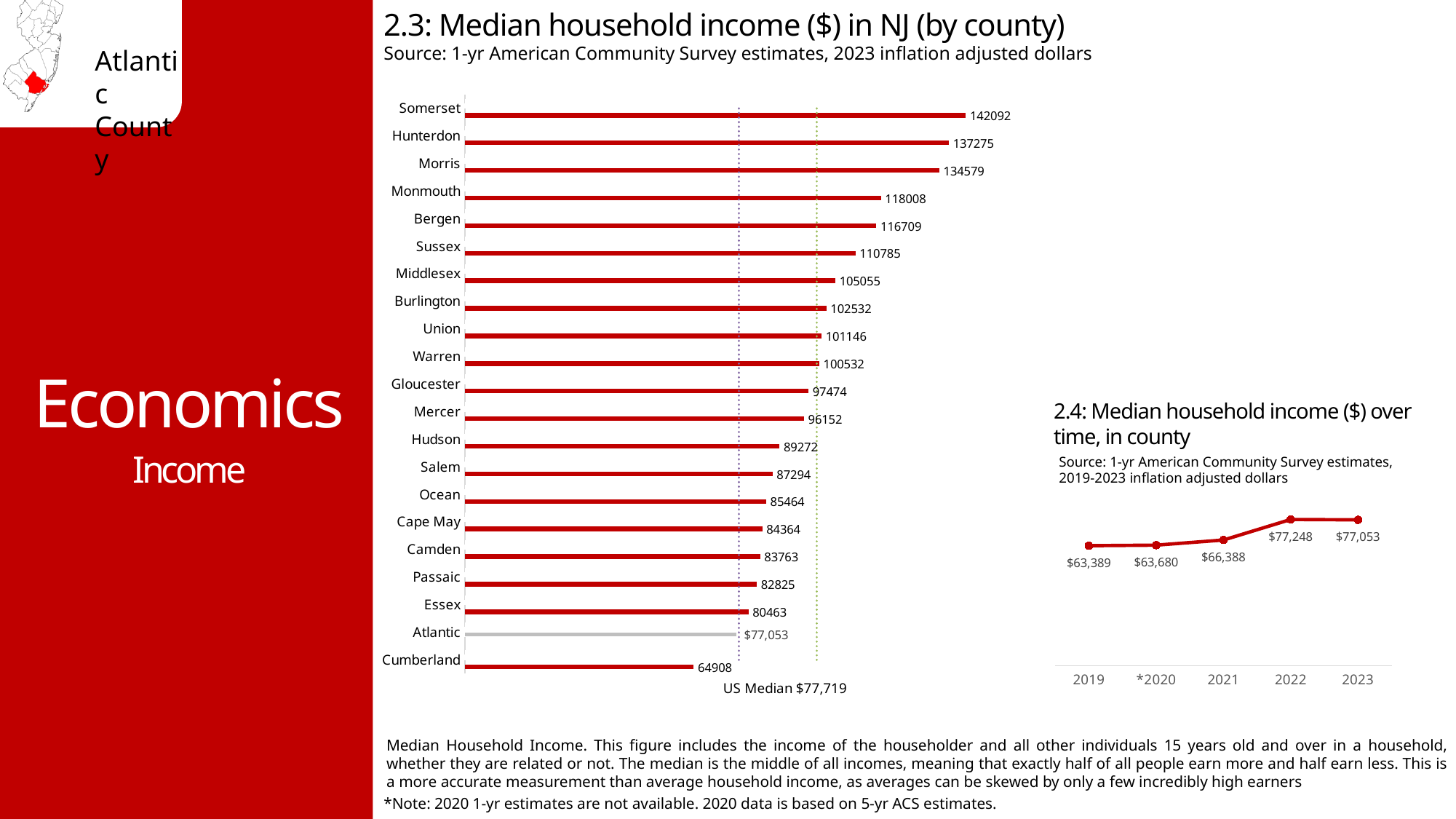
In chart 2.3 (Median household income in NJ by county), which county has the lowest median household income? Cumberland In chart 2.3 (Median household income in NJ by county), what is the median household income for Somerset? 142092 In chart 2.3 (Median household income in NJ by county), how many counties are plotted? 21 In chart 2.3 (Median household income in NJ by county), which county has the highest median household income? Somerset In chart 2.4 (Median household income over time, in county), which year has the highest median household income? 2022 What kind of chart is chart 2.3 (Median household income in NJ by county)? Bar chart In chart 2.4 (Median household income over time, in county), how many years are plotted? 5 In chart 2.4 (Median household income over time, in county), what is the median household income for 2019? $63,389 In chart 2.3 (Median household income in NJ by county), what is the difference between Somerset's and Cumberland's median household income? 77184 In chart 2.3 (Median household income in NJ by county), which has a higher median household income, Monmouth or Bergen? Monmouth In chart 2.3 (Median household income in NJ by county), what is the value shown for Atlantic? $77,053 In chart 2.4 (Median household income over time, in county), does the median household income generally rise or fall from 2019 to 2023? Rise